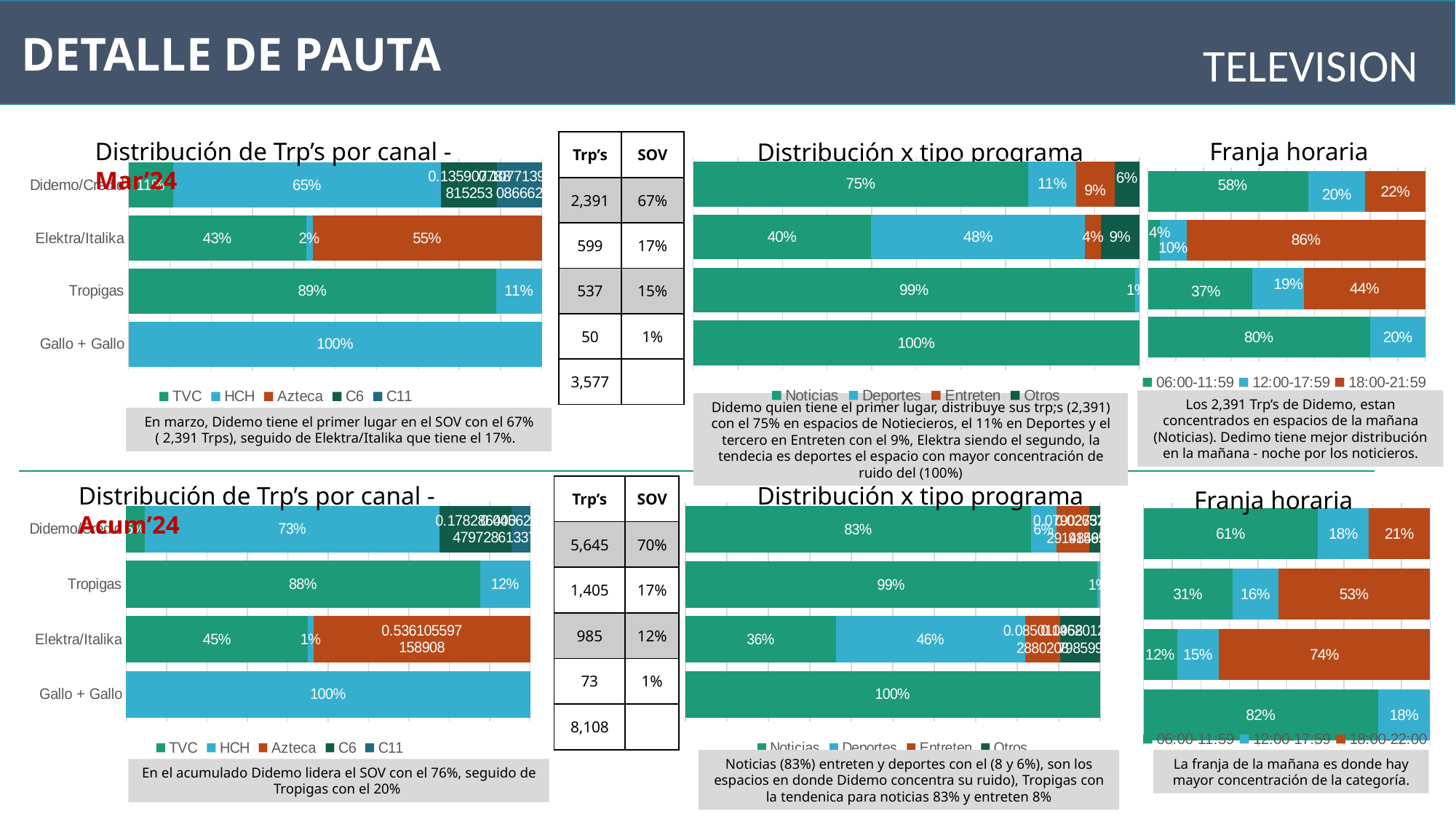
In the 'Distribución de Trp's por canal - Mar'24' chart, how many series does the legend list? 5 In the 'Distribución de Trp's por canal - Mar'24' chart, what is the TVC share for Tropigas? 89% What kind of chart is the 'Distribución de Trp's por canal - Acum'24' chart? Stacked bar chart In the bottom 'Franja horaria' chart, which time slot does the legend list last? 18:00-22:00 In the top 'Franja horaria' chart, what is the 18:00-21:59 share in the second bar from the top? 86% In the top 'Distribución x tipo programa' chart, what is the Noticias share in the top bar? 75% In the bottom 'Franja horaria' chart, what is the 06:00-11:59 share in the bottom bar? 82% In the 'Distribución de Trp's por canal - Acum'24' chart, what is the HCH share for Tropigas? 12% In the 'Distribución de Trp's por canal - Mar'24' chart, how many channel categories are shown? 4 In the top 'Distribución x tipo programa' chart, which series has the largest share in the second bar from the top? Deportes In the 'Distribución de Trp's por canal - Mar'24' chart, what is the Azteca share for Elektra/Italika? 55% In the 'Distribución de Trp's por canal - Acum'24' chart, what is the difference between the TVC share of Tropigas and the TVC share of Elektra/Italika? 43%